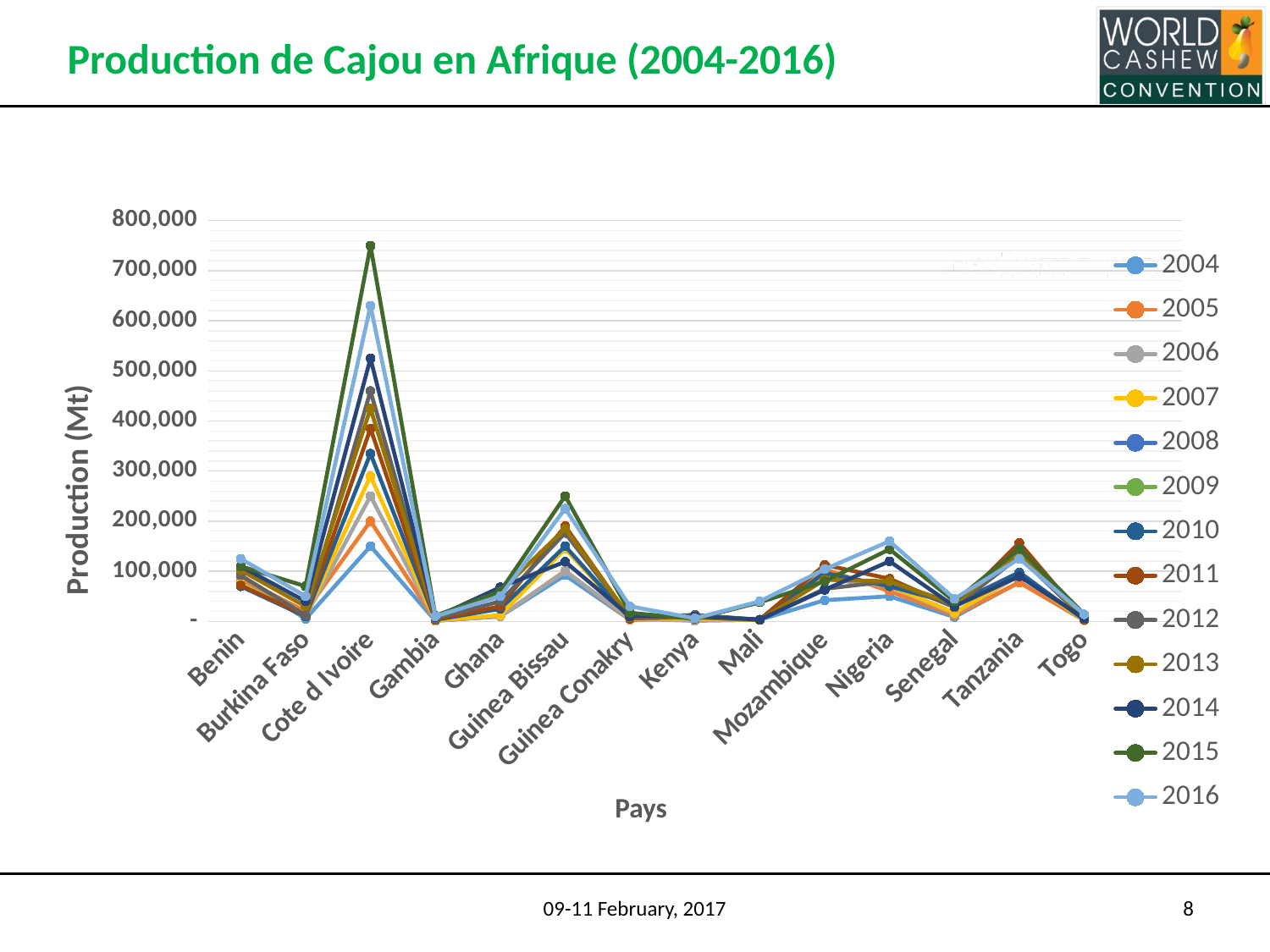
Which year's series reaches the highest value for Cote d Ivoire? 2015 How many countries are shown on the x axis of the chart? 14 What kind of chart is shown on the slide? line chart Is the 2016 production value for Gambia greater or less than 100,000? less Is the 2015 production value for Guinea Bissau greater or less than 200,000? greater In 2015, which country has the larger production: Cote d Ivoire or Guinea Bissau? Cote d Ivoire Is the 2015 production value for Cote d Ivoire greater or less than 700,000? greater Which country has the highest cashew production in the chart? Cote d Ivoire What is the title of the chart on the slide? Production de Cajou en Afrique (2004-2016) How many series does the chart legend list? 13 What is the label of the y axis of the chart? Production (Mt)